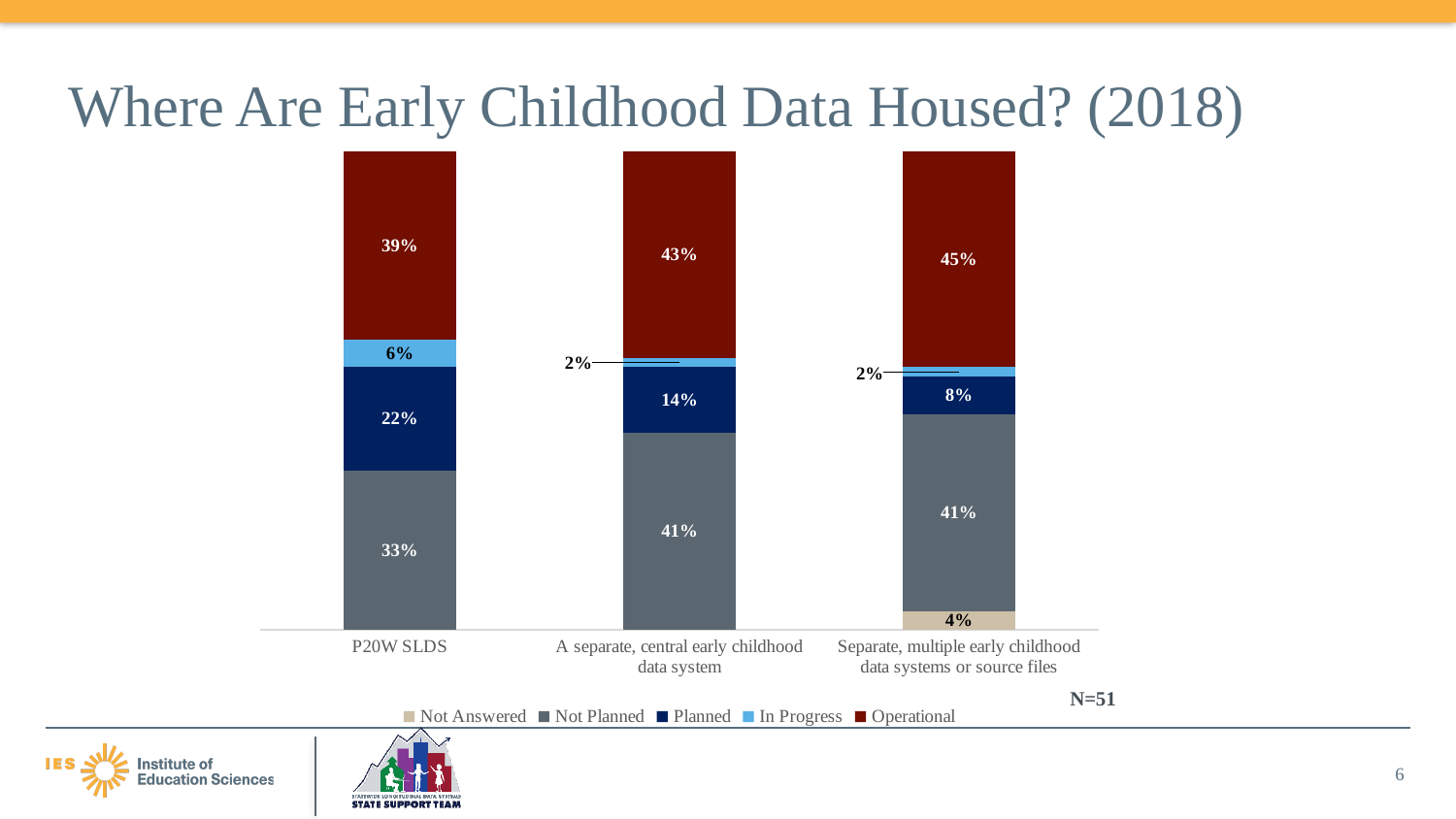
What is the Not Answered value for 'Separate, multiple early childhood data systems or source files'? 4% Which category has the lowest Planned value? Separate, multiple early childhood data systems or source files What is the Planned value for P20W SLDS? 22% What is the difference between the Planned values for P20W SLDS and 'A separate, central early childhood data system'? 8% How many categories are shown on the x axis of the chart? 3 What sample size (N) is shown on the slide? N=51 What is the Operational value for P20W SLDS? 39% What kind of chart is shown on the slide? Stacked bar chart Which category has the highest Operational value? Separate, multiple early childhood data systems or source files What is the Not Planned value for 'A separate, central early childhood data system'? 41% Which is larger: the In Progress value for P20W SLDS or for 'A separate, central early childhood data system'? P20W SLDS How many series does the legend list? 5